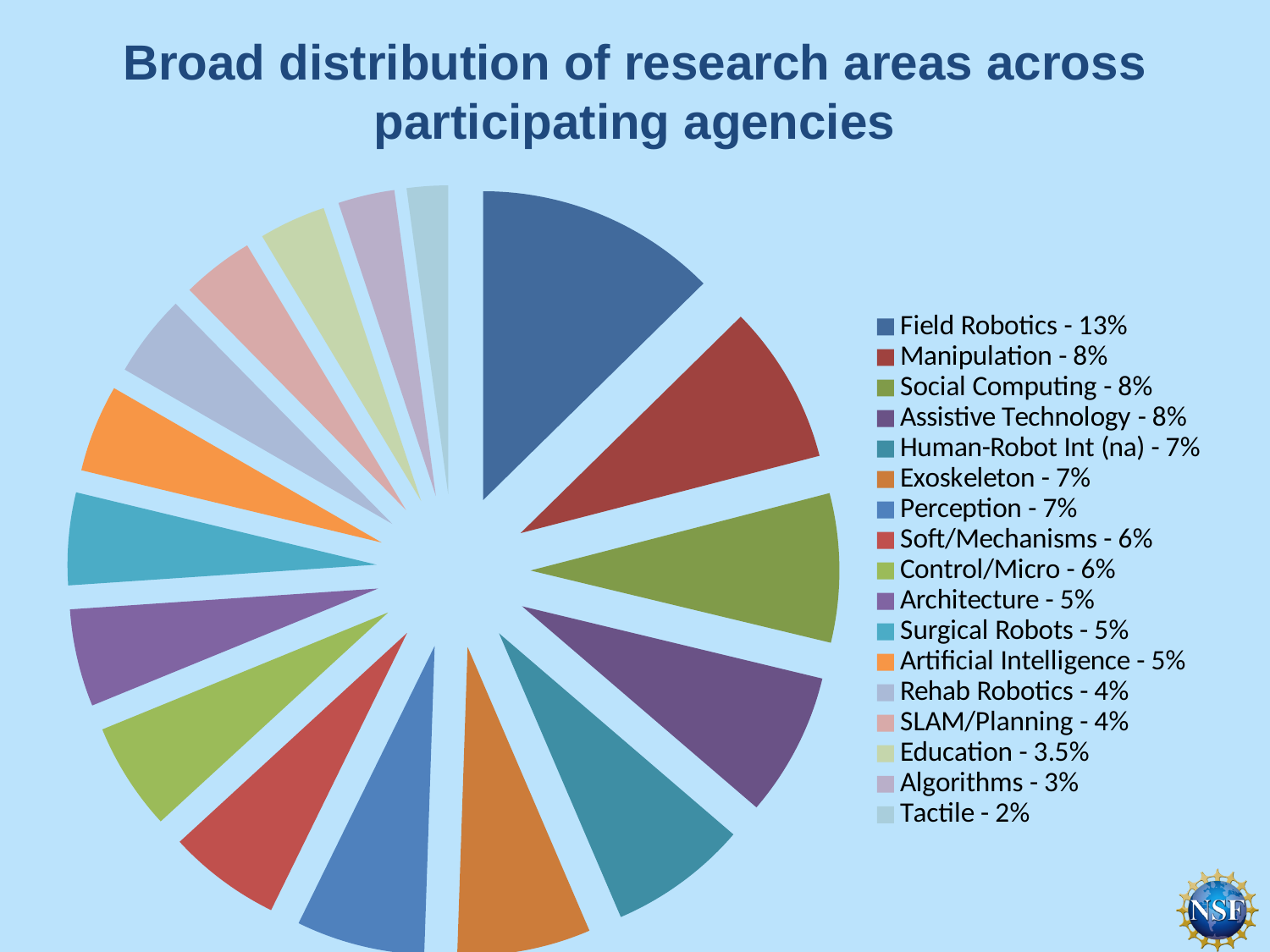
What is the title of the chart on the slide? Broad distribution of research areas across participating agencies What percentage is shown for Rehab Robotics? 4% How many research areas (slices) does the pie chart show? 17 What percentage is shown for Exoskeleton? 7% What share of the pie does Field Robotics represent? 13% Which has a larger share, Social Computing or Algorithms? Social Computing What percentage is shown for Surgical Robots? 5% Which research area has the largest share of the pie? Field Robotics What percentage is shown for Education? 3.5% Which research area has the smallest share of the pie? Tactile What kind of chart is shown on the slide? pie chart What is the difference in percentage points between Field Robotics and Manipulation? 5